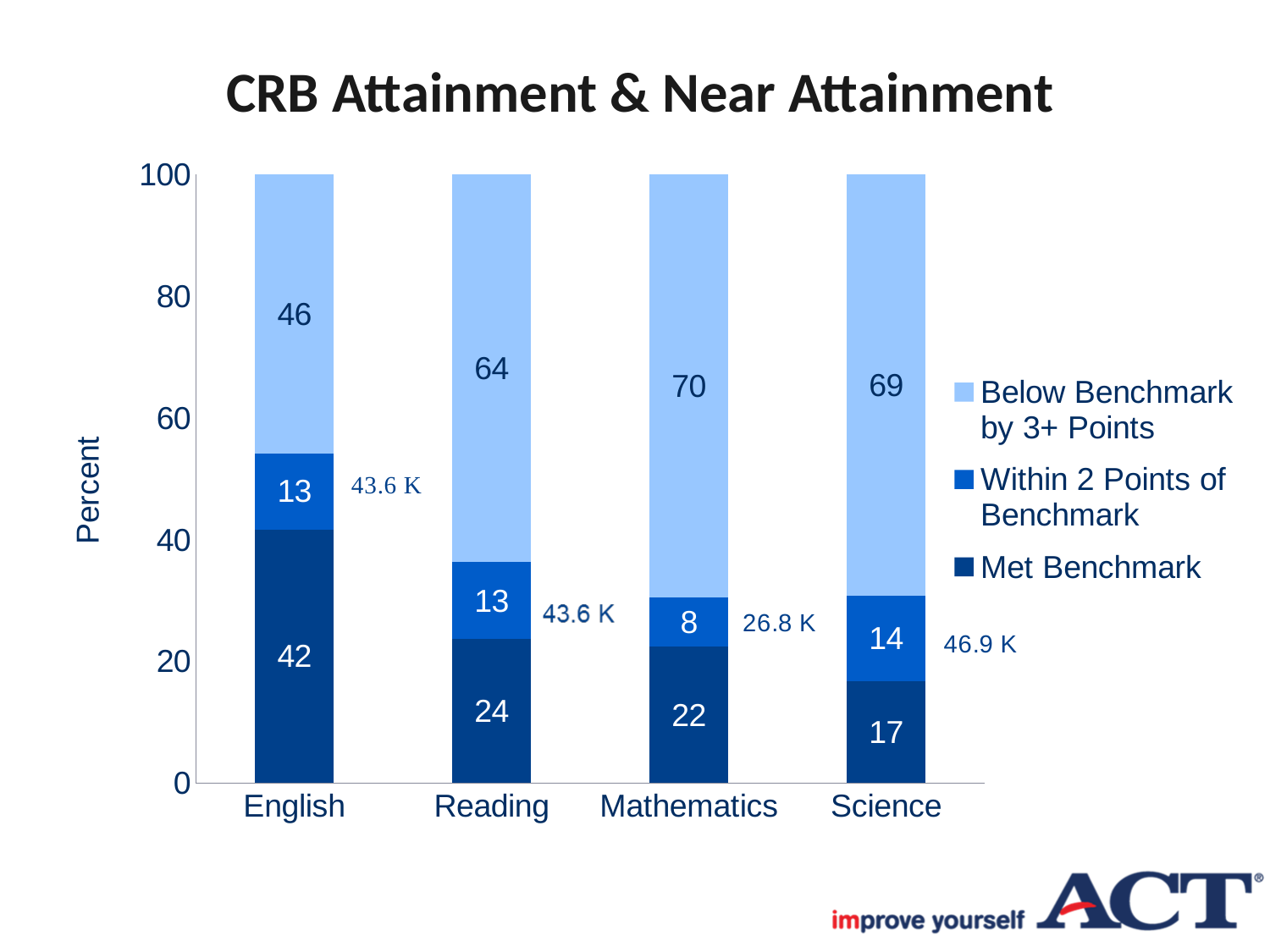
What is the Below Benchmark by 3+ Points value for Mathematics? 70 What is the Met Benchmark value for English? 42 What kind of chart is shown? Stacked bar chart Which subject has the lowest Within 2 Points of Benchmark value? Mathematics What is the total of the stacked bar for Mathematics? 100 What is the difference between the Met Benchmark values for Reading and Science? 7 How many subjects are shown on the x axis? 4 How many series does the legend list? 3 Which subject has the highest Met Benchmark value? English Which is larger, the Below Benchmark by 3+ Points value for Reading or for Science? Science What is the Within 2 Points of Benchmark value for Science? 14 What is the title of the chart? CRB Attainment & Near Attainment